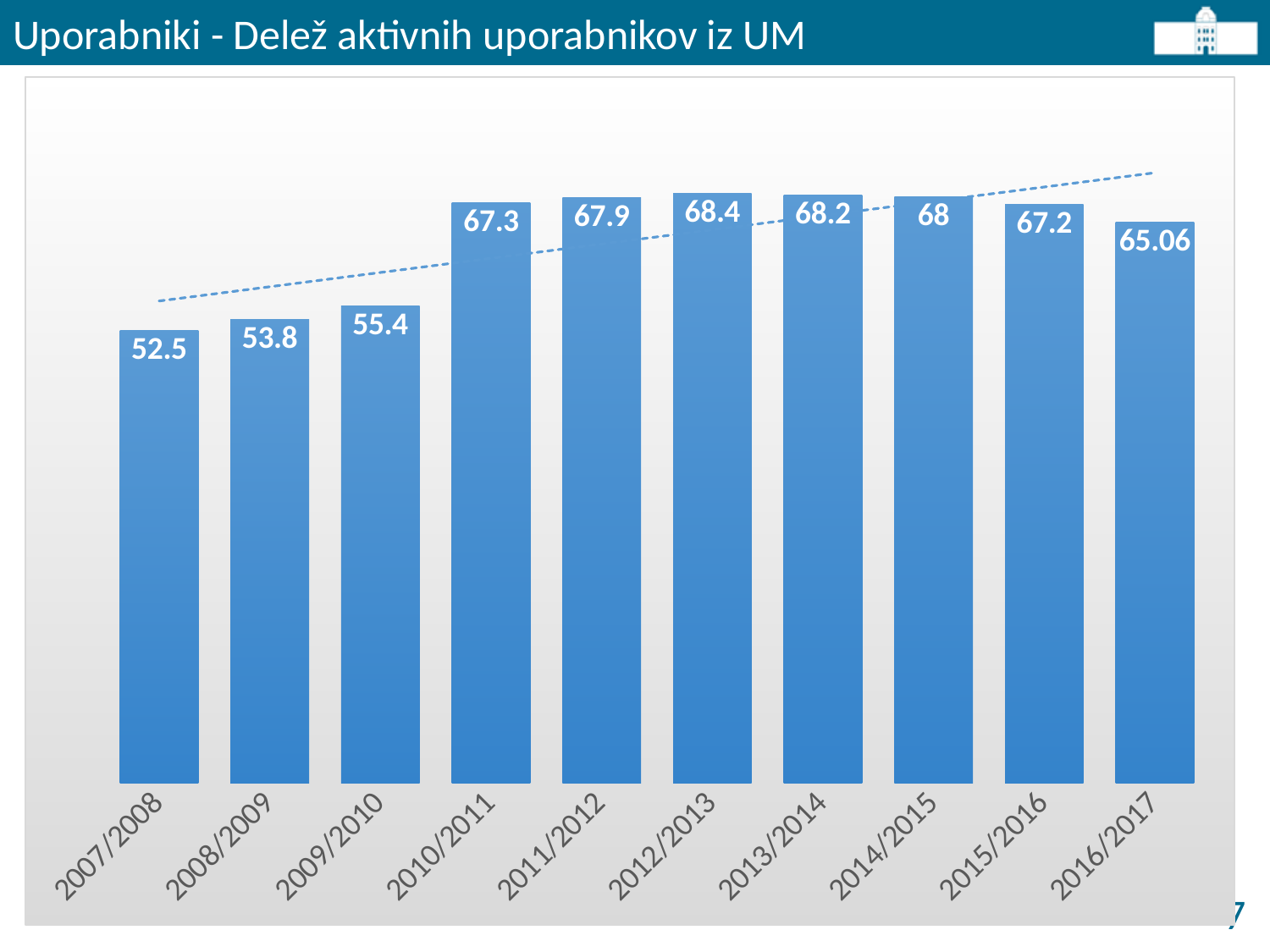
How many academic years are shown on the x axis? 10 What is the value for 2007/2008? 52.5 What is the value for 2016/2017? 65.06 Which is larger, the value for 2008/2009 or the value for 2015/2016? 2015/2016 Which academic year has the highest value? 2012/2013 What is the title of the slide? Uporabniki - Delež aktivnih uporabnikov iz UM Do the values rise or fall from 2007/2008 to 2012/2013? rise Which academic year has the lowest value? 2007/2008 What is the difference between the values for 2010/2011 and 2009/2010? 11.9 What kind of chart is shown on the slide? bar chart What is the value for 2010/2011? 67.3 What is the value for 2012/2013? 68.4